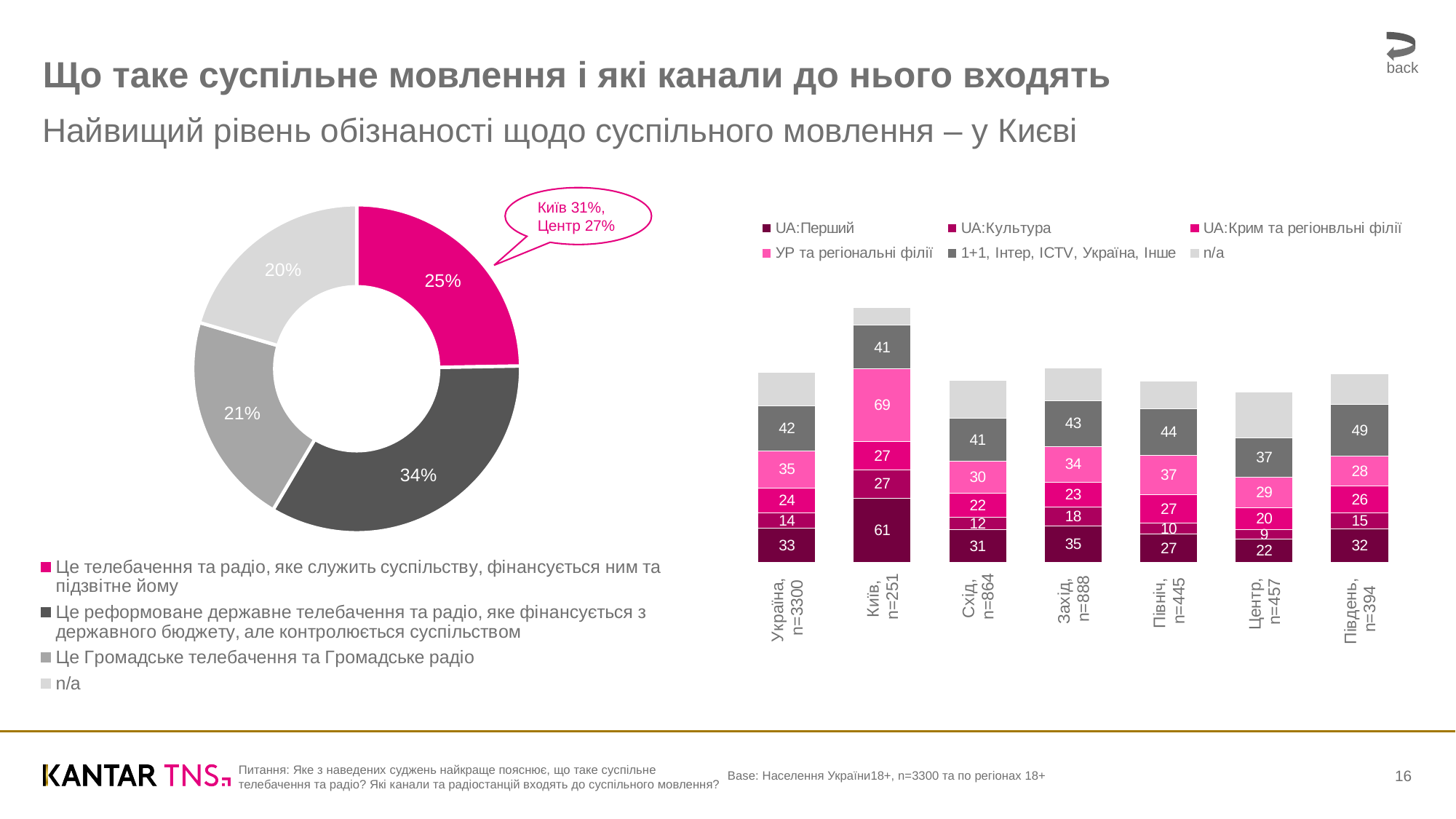
What type of chart is the chart on the right of the slide? Stacked bar chart In the stacked bar chart on the right, which region has the lowest value for UA:Культура? Центр, n=457 In the stacked bar chart on the right, what is the value of УР та регіональні філії for Північ, n=445? 37 In the stacked bar chart on the right, which region has the highest value for UA:Перший? Київ, n=251 In the stacked bar chart on the right, what is the value of UA:Перший for Київ, n=251? 61 In the donut chart on the left, what share is shown for the segment 'Це реформоване державне телебачення та радіо, яке фінансується з державного бюджету, але контролюється суспільством'? 34% In the stacked bar chart on the right, how many series does the legend list? 6 In the stacked bar chart on the right, what is the difference between the UA:Перший values for Київ, n=251 and Україна, n=3300? 28 In the stacked bar chart on the right, which is larger: the value of 1+1, Інтер, ICTV, Україна, Інше for Південь, n=394 or for Центр, n=457? Південь, n=394 In the donut chart on the left, what share is shown for the 'n/a' segment? 20% In the donut chart on the left, which segment has the largest share? Це реформоване державне телебачення та радіо, яке фінансується з державного бюджету, але контролюється суспільством In the donut chart on the left, how many segments are there? 4